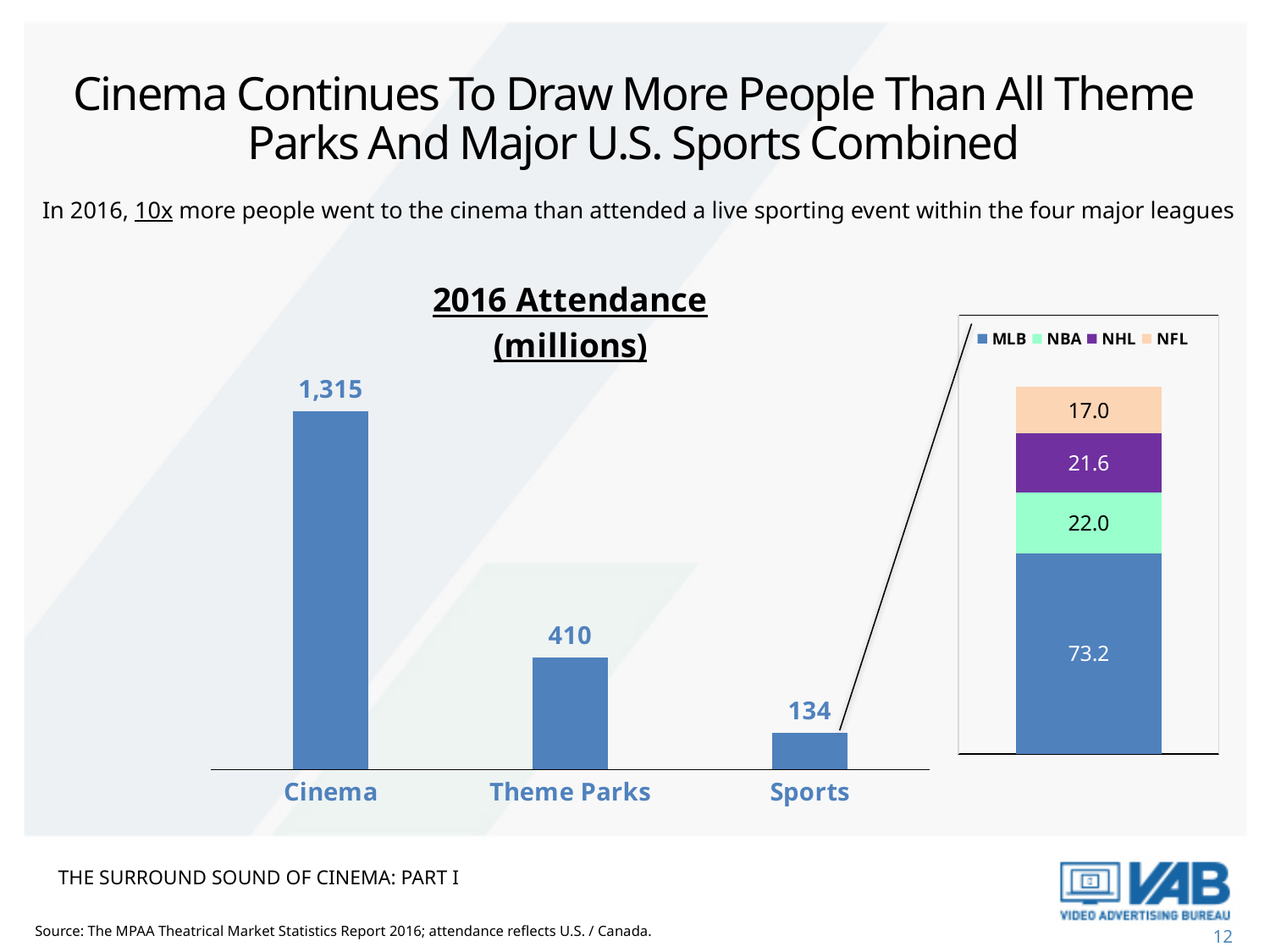
In the 2016 Attendance (millions) bar chart, which category has the lowest attendance? Sports In the stacked bar on the right of the slide, what is the value for NFL? 17.0 In the 2016 Attendance (millions) bar chart, how many categories are shown? 3 In the 2016 Attendance (millions) bar chart, what is the value for Sports? 134 In the 2016 Attendance (millions) bar chart, which category has the highest attendance? Cinema In the 2016 Attendance (millions) bar chart, what is the value for Theme Parks? 410 How many series does the legend of the stacked bar on the right of the slide list? 4 What kind of chart is the 2016 Attendance (millions) chart? Bar chart In the stacked bar on the right of the slide, what is the value for MLB? 73.2 In the 2016 Attendance (millions) bar chart, what is the value for Cinema? 1,315 In the stacked bar on the right of the slide, which league has the largest segment? MLB In the 2016 Attendance (millions) bar chart, what is the difference between the Cinema and Theme Parks values? 905